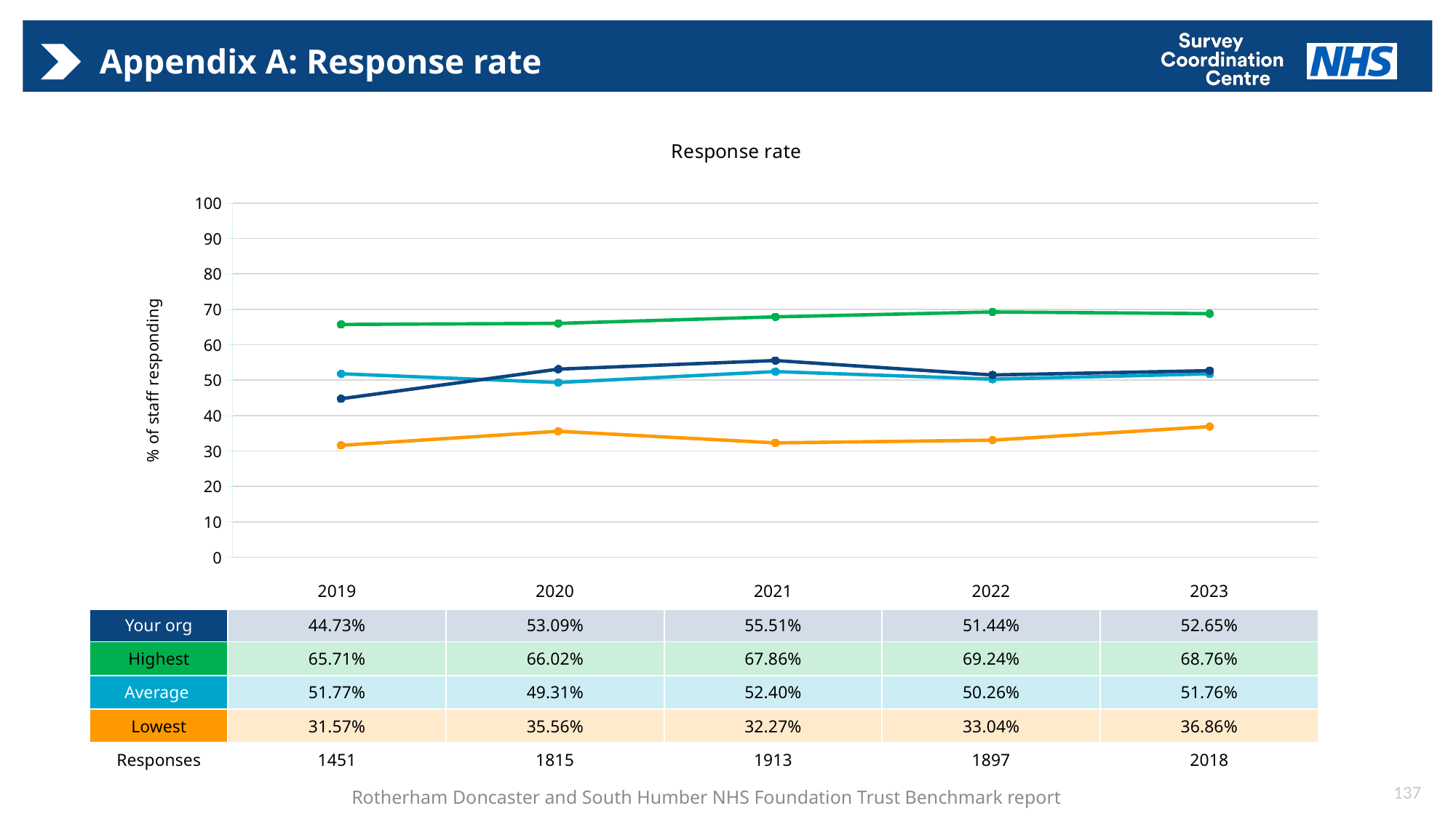
What is the difference between the Highest and Your org response rates in 2023? 16.11% What kind of chart is shown on the slide? Line chart How many years are shown on the x axis? 5 What is the response rate for Your org in 2021? 55.51% What is the Highest response rate in 2022? 69.24% How many responses were there in 2023? 2018 What is the Average response rate in 2020? 49.31% In which year was the Your org response rate highest? 2021 What is the Lowest response rate in 2023? 36.86% Which was larger in 2019, the Your org response rate or the Average response rate? Average In which year was the Your org response rate lowest? 2019 How many series are plotted on the chart? 4